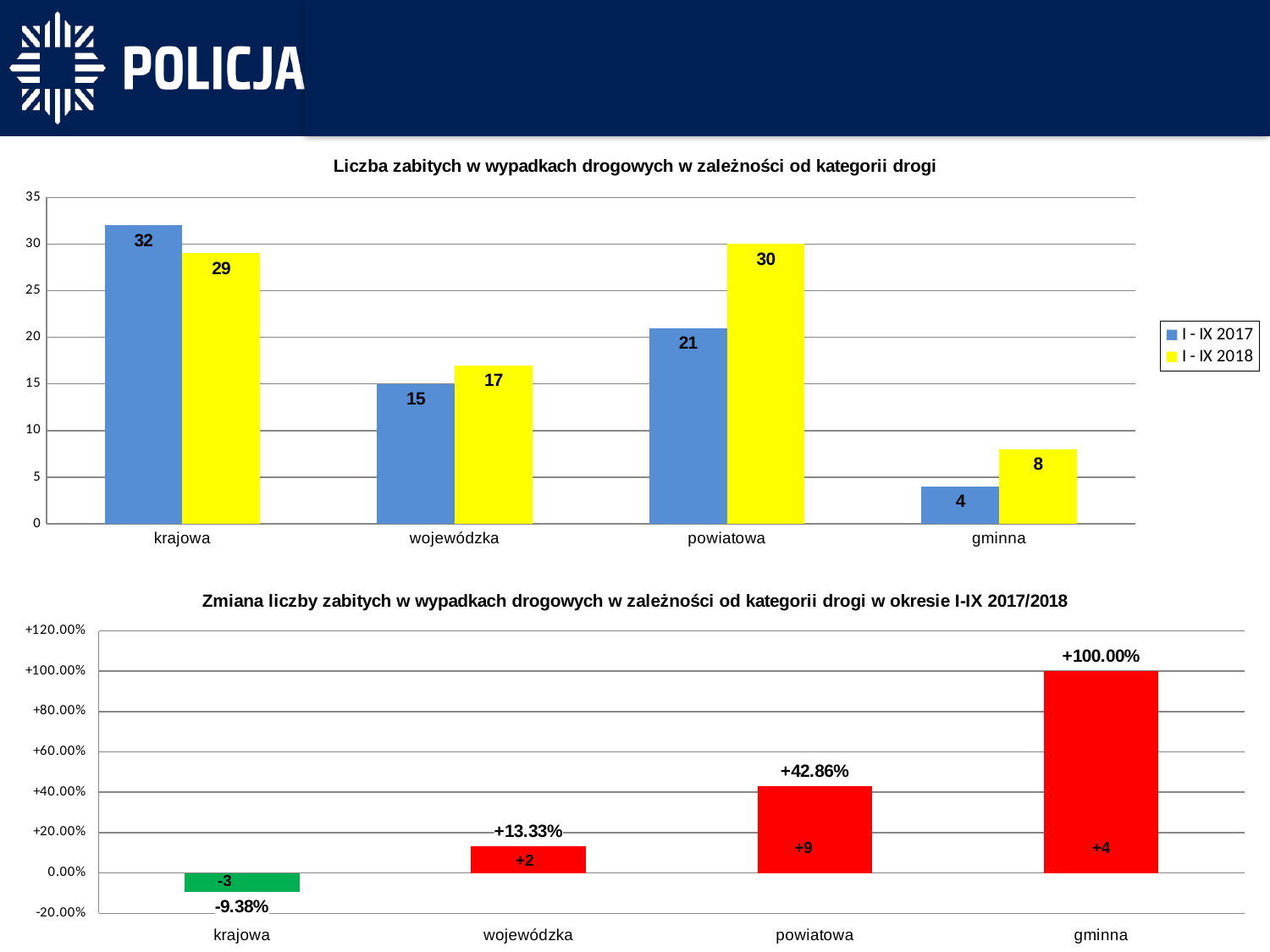
In the bottom chart, what colour is the bar for krajowa? green In the top chart, which road category has the highest value for I - IX 2018? powiatowa How many series does the legend of the top chart list? 2 In the bottom chart, which road category has the lowest percentage change? krajowa In the top chart 'Liczba zabitych w wypadkach drogowych w zależności od kategorii drogi', what is the value for krajowa in I - IX 2017? 32 What kind of chart is the bottom chart 'Zmiana liczby zabitych w wypadkach drogowych...'? bar chart In the top chart, which road category has the lowest value for I - IX 2017? gminna How many road categories are shown on the x axis of the top chart? 4 In the top chart, which is larger for wojewódzka: I - IX 2017 or I - IX 2018? I - IX 2018 In the top chart, what is the difference between the I - IX 2018 and I - IX 2017 values for gminna? 4 In the bottom chart, what is the percentage change shown for powiatowa? +42.86% In the top chart, what is the value for powiatowa in I - IX 2018? 30